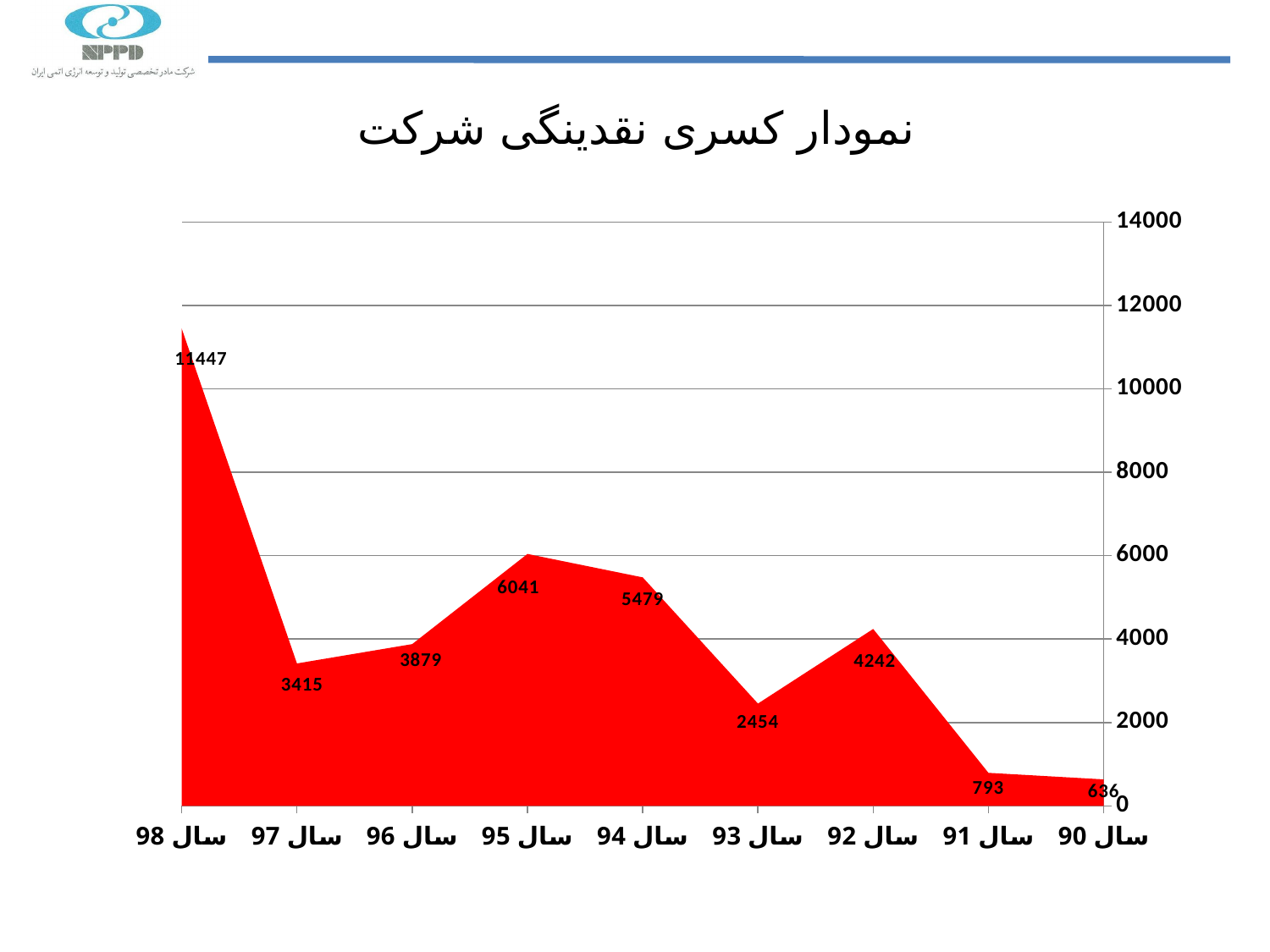
What is the difference between the values for سال 98 and سال 97? 8032 What is the difference between the values for سال 95 and سال 94? 562 What is the value for سال 95? 6041 What is the value for سال 90? 636 Which year has the highest value? سال 98 Do the values generally rise or fall moving from سال 98 on the left to سال 90 on the right? Fall Which is larger, the value for سال 92 or the value for سال 96? سال 92 Which year has the lowest value? سال 90 What is the value for سال 93? 2454 How many years are plotted on the chart? 9 What kind of chart is shown on the slide? Area chart What is the value for سال 98? 11447